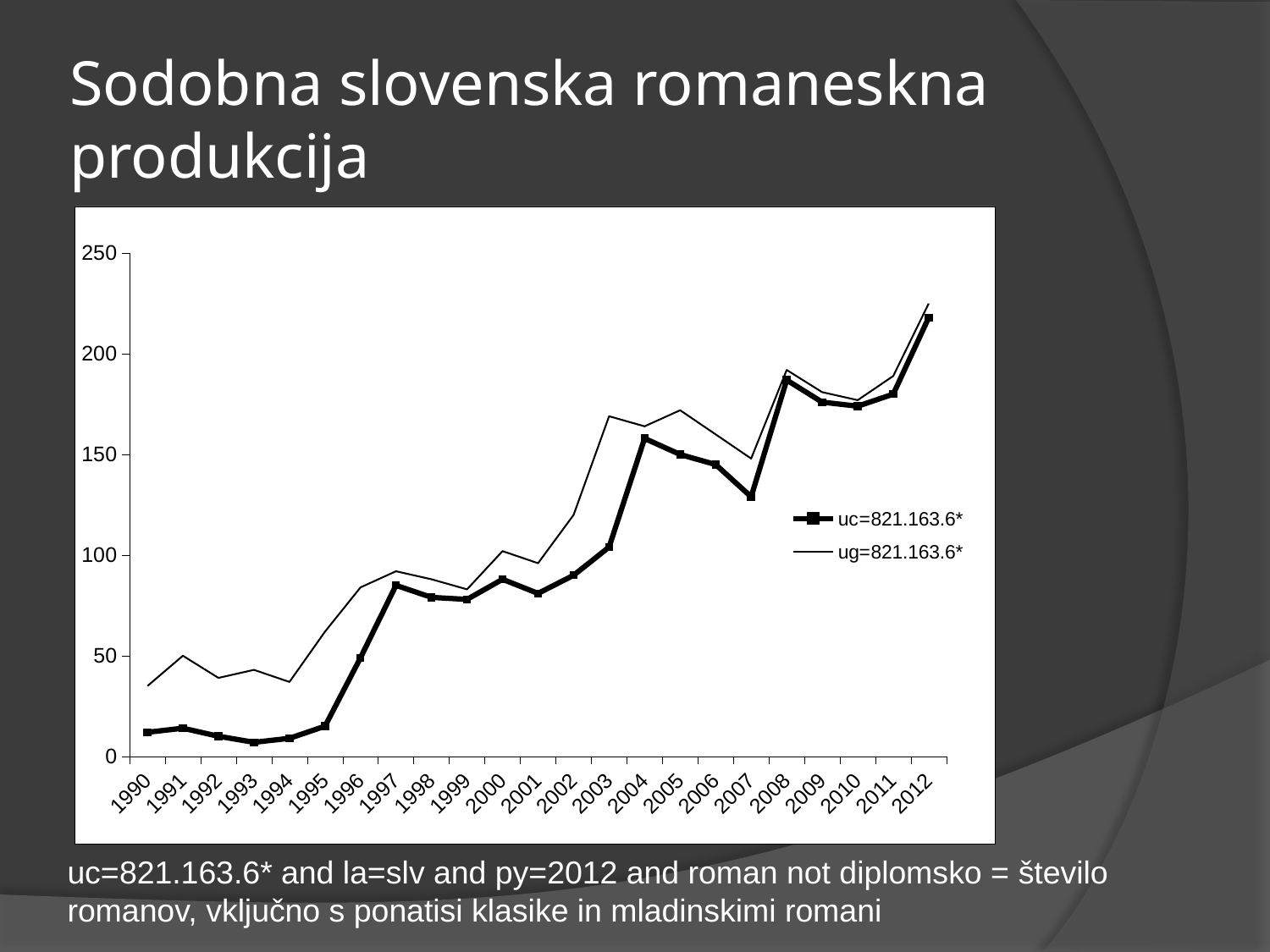
Is the value for uc=821.163.6* in 1990 greater or less than 50? less How many series does the legend list? 2 In which year does the uc=821.163.6* series reach its highest value? 2012 Is the value for ug=821.163.6* in 2008 greater or less than 150? greater What is the first year shown on the x axis? 1990 Is the value for uc=821.163.6* in 2012 greater or less than 200? greater What kind of chart is shown on the slide? line chart In 2003, which series has the higher value, uc=821.163.6* or ug=821.163.6*? ug=821.163.6* Do the values of the uc=821.163.6* series generally rise or fall from 1990 to 2012? rise How many years are plotted along the x axis? 23 Which series is drawn with the thick line and square markers? uc=821.163.6*